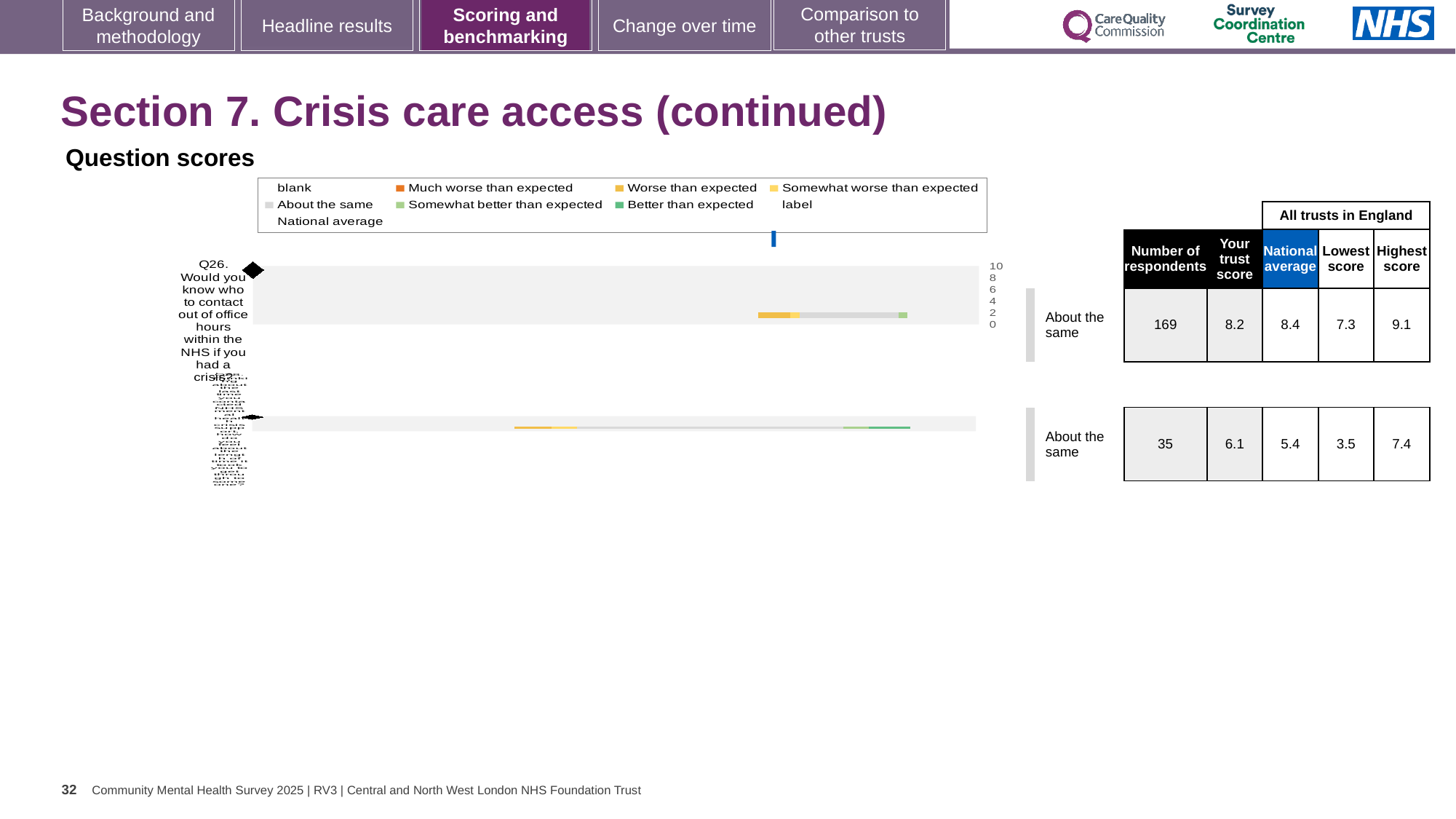
What is the highest score among all trusts in England for Q26? 9.1 For Q26, which is larger: the trust score or the national average? national average What is the lowest score among all trusts in England for Q26? 7.3 How many respondents answered Q26? 169 How is the trust's result for Q26 categorised relative to expectations? About the same How many question bars are plotted in the chart? 2 What is the national average score for Q26? 8.4 What is the trust score for Q26 (Would you know who to contact out of office hours within the NHS if you had a crisis?)? 8.2 For Q26, how much higher is the national average than the trust score? 0.2 For Q26, what is the difference between the highest score and the lowest score across all trusts in England? 1.8 What is the heading above the chart? Question scores What kind of chart is shown under 'Question scores'? bar chart